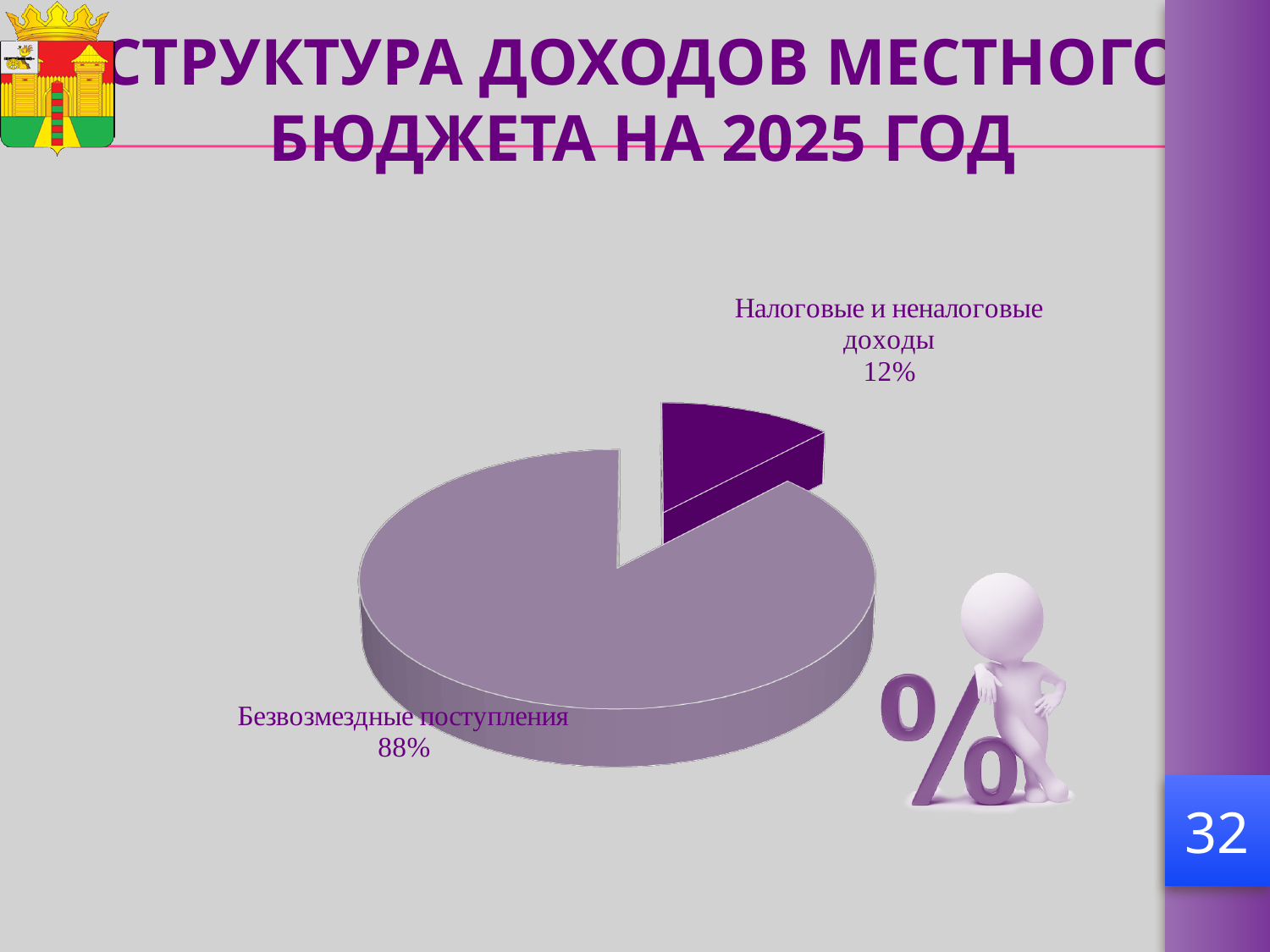
Which slice of the pie is drawn in dark purple? Налоговые и неналоговые доходы How many slices does the pie chart have? 2 Which is larger: the share for "Безвозмездные поступления" or for "Налоговые и неналоговые доходы"? Безвозмездные поступления What is the title of the slide containing the pie chart? СТРУКТУРА ДОХОДОВ МЕСТНОГО БЮДЖЕТА НА 2025 ГОД What share of the pie does "Безвозмездные поступления" have? 88% What share of the pie does "Налоговые и неналоговые доходы" have? 12% What kind of chart is shown on the slide? pie chart Which category has the largest slice of the pie? Безвозмездные поступления What is the difference in percentage points between "Безвозмездные поступления" and "Налоговые и неналоговые доходы"? 76 Which category has the smallest slice of the pie? Налоговые и неналоговые доходы